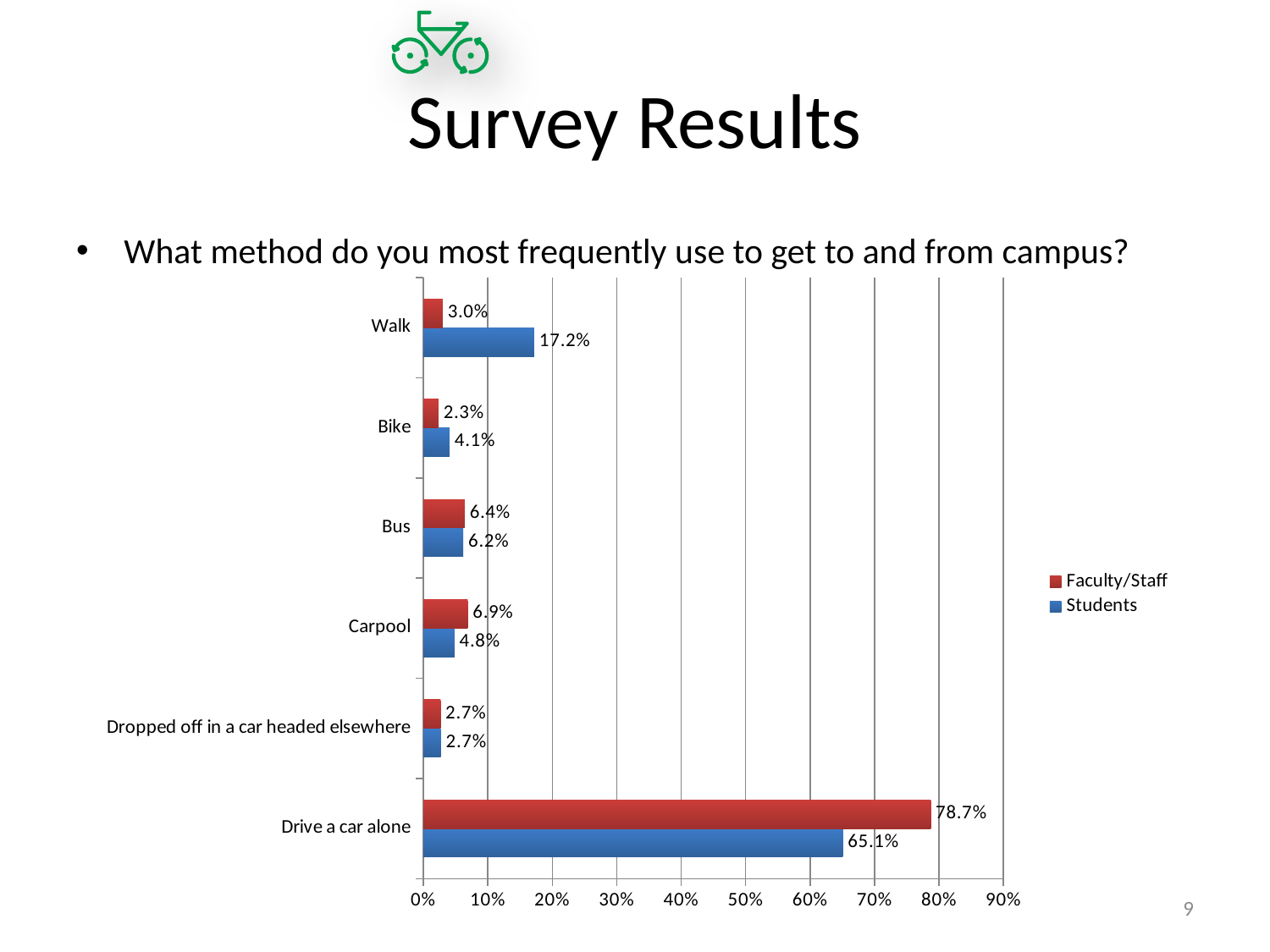
What is the difference between the Faculty/Staff and Students values for Drive a car alone? 13.6% What percentage of Students most frequently walk to and from campus? 17.2% Which colour represents Faculty/Staff in the chart? Red What is the Faculty/Staff value for Carpool? 6.9% Which category has the lowest value for Faculty/Staff? Bike Which category has the highest value for Students? Drive a car alone What percentage of Faculty/Staff most frequently drive a car alone? 78.7% What is the Students value for Bike? 4.1% What kind of chart is shown on the slide? Bar chart Which is larger for Walk: the Faculty/Staff value or the Students value? Students How many categories are shown on the chart? 6 How many series does the legend list? 2